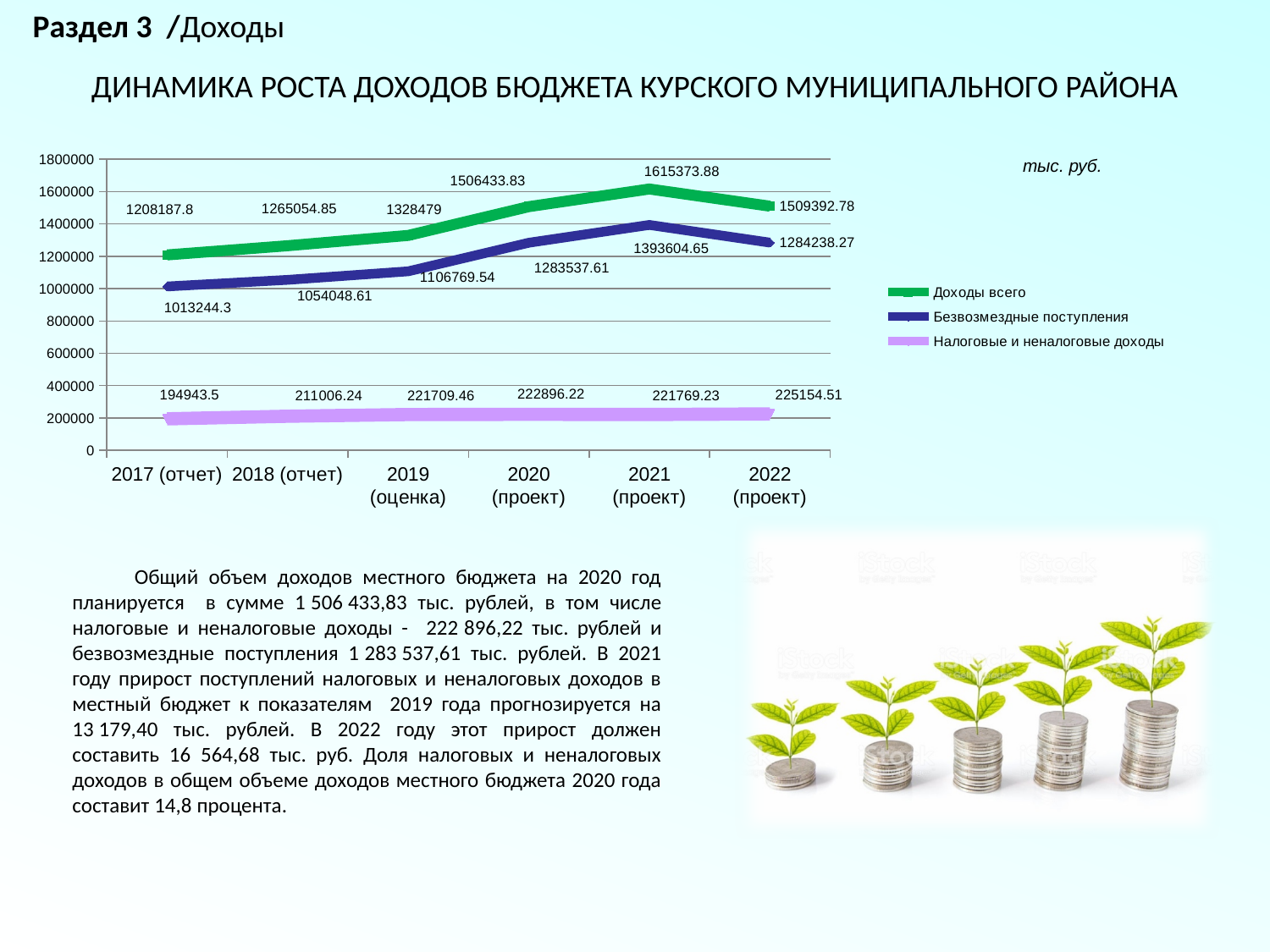
Does Доходы всего rise or fall from 2017 (отчет) to 2021 (проект)? rise Which colour represents Доходы всего in the chart? green What is the value of Доходы всего for 2020 (проект)? 1506433.83 What type of chart is shown on the slide? line chart What is the value of Налоговые и неналоговые доходы for 2022 (проект)? 225154.51 What is the difference between Доходы всего in 2021 (проект) and 2020 (проект)? 108940.05 What is the value of Безвозмездные поступления for 2017 (отчет)? 1013244.3 How many series does the legend list? 3 In which year is Налоговые и неналоговые доходы lowest? 2017 (отчет) Which is larger: Безвозмездные поступления in 2021 (проект) or in 2022 (проект)? 2021 (проект) How many categories (years) are shown on the x axis? 6 In which year is Доходы всего highest? 2021 (проект)